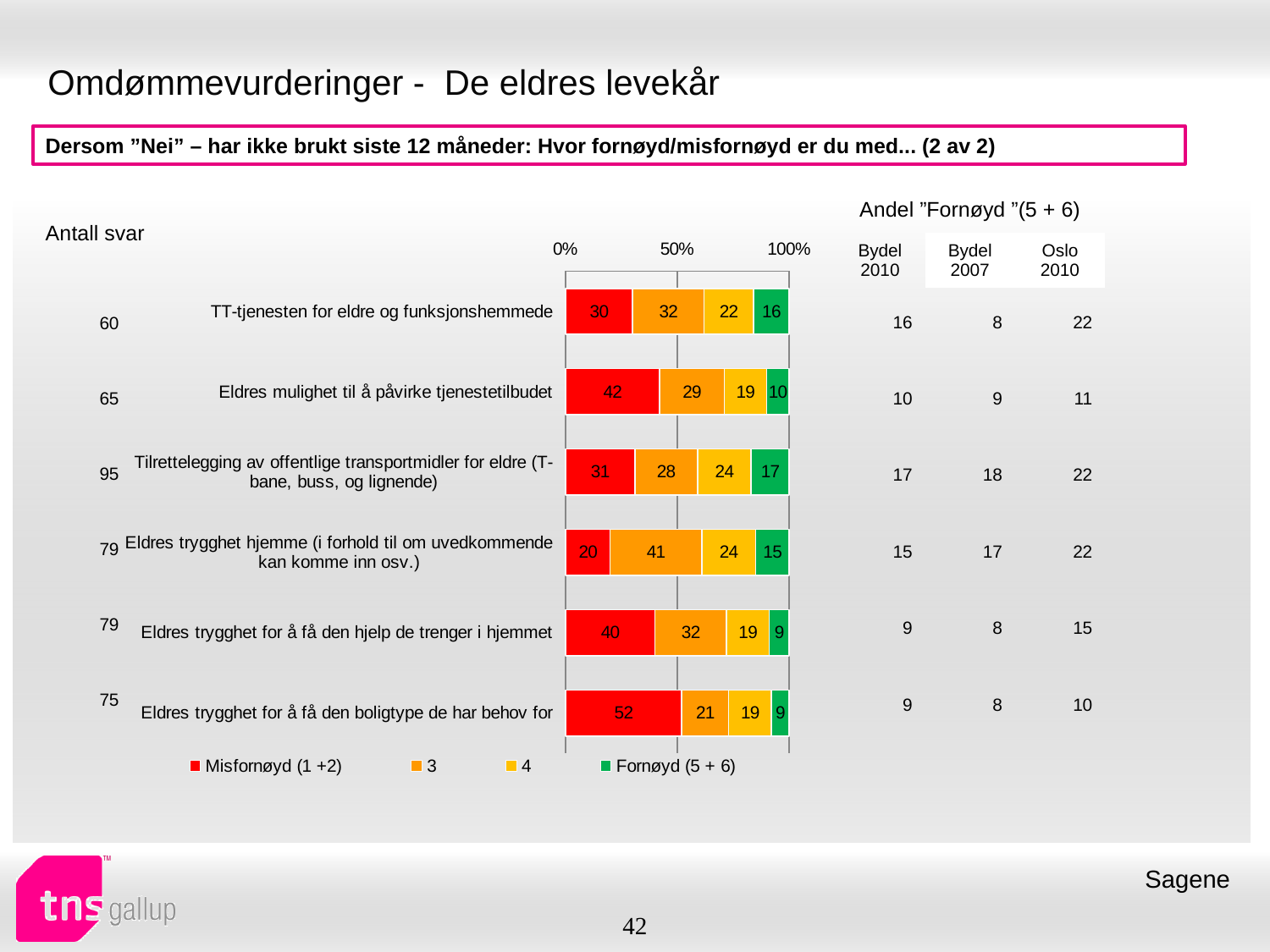
What is the difference between the Misfornøyd (1 +2) values for "Eldres trygghet for å få den boligtype de har behov for" and "Eldres trygghet hjemme (i forhold til om uvedkommende kan komme inn osv.)"? 32 How many series does the chart legend list? 4 What kind of chart is shown on the slide? Stacked bar chart How many categories are shown in the bar chart? 6 Which has a larger Fornøyd (5 + 6) value: "Tilrettelegging av offentlige transportmidler for eldre" or "Eldres mulighet til å påvirke tjenestetilbudet"? Tilrettelegging av offentlige transportmidler for eldre What is the value of the Misfornøyd (1 +2) segment for "Eldres trygghet for å få den boligtype de har behov for"? 52 Which category has the highest Misfornøyd (1 +2) value? Eldres trygghet for å få den boligtype de har behov for What is the total of the stacked bar for "Eldres trygghet for å få den hjelp de trenger i hjemmet"? 100 Which category has the lowest Misfornøyd (1 +2) value? Eldres trygghet hjemme (i forhold til om uvedkommende kan komme inn osv.) What is the value of the "3" segment for "Eldres trygghet hjemme (i forhold til om uvedkommende kan komme inn osv.)"? 41 What is the value of the Fornøyd (5 + 6) segment for "TT-tjenesten for eldre og funksjonshemmede"? 16 What is the first entry in the chart legend? Misfornøyd (1 +2)